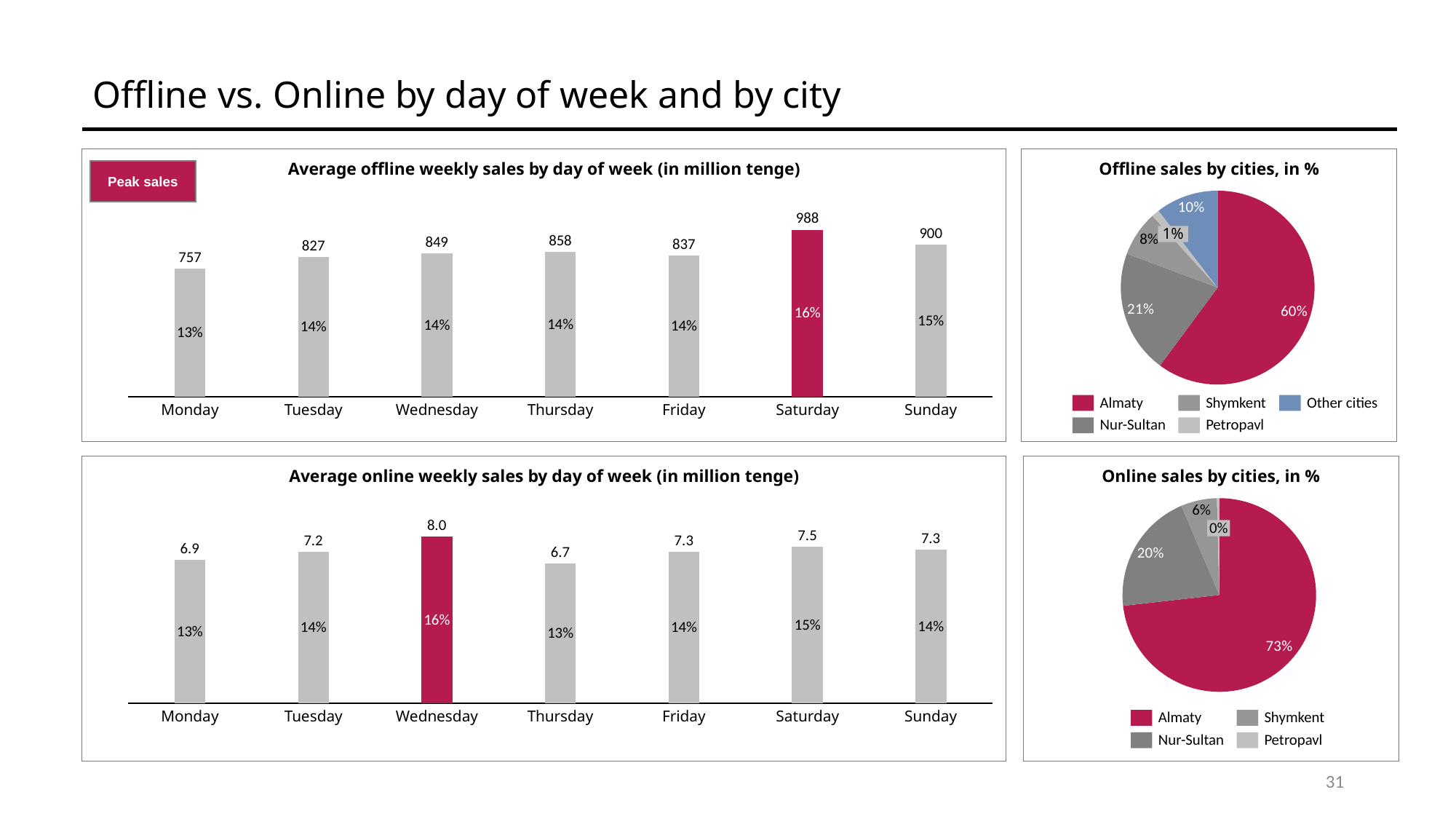
In the 'Average online weekly sales by day of week' chart, which is larger, Tuesday or Saturday? Saturday How many entries does the legend of the 'Online sales by cities, in %' pie chart list? 4 In the 'Average online weekly sales by day of week' chart, which day has the highest value? Wednesday In the 'Average offline weekly sales by day of week' chart, what is the value for Saturday? 988 In the 'Average online weekly sales by day of week' chart, what is the value for Thursday? 6.7 In the 'Average offline weekly sales by day of week' chart, which day has the lowest value? Monday How many days are shown in the 'Average online weekly sales by day of week' chart? 7 In the 'Average offline weekly sales by day of week' chart, what percentage share is shown on the Sunday bar? 15% In the 'Offline sales by cities, in %' pie chart, what share does Almaty have? 60% What type of chart is 'Online sales by cities, in %'? Pie chart In the 'Offline sales by cities, in %' pie chart, what share does Nur-Sultan have? 21% In the 'Average offline weekly sales by day of week' chart, what is the difference between Saturday and Monday? 231